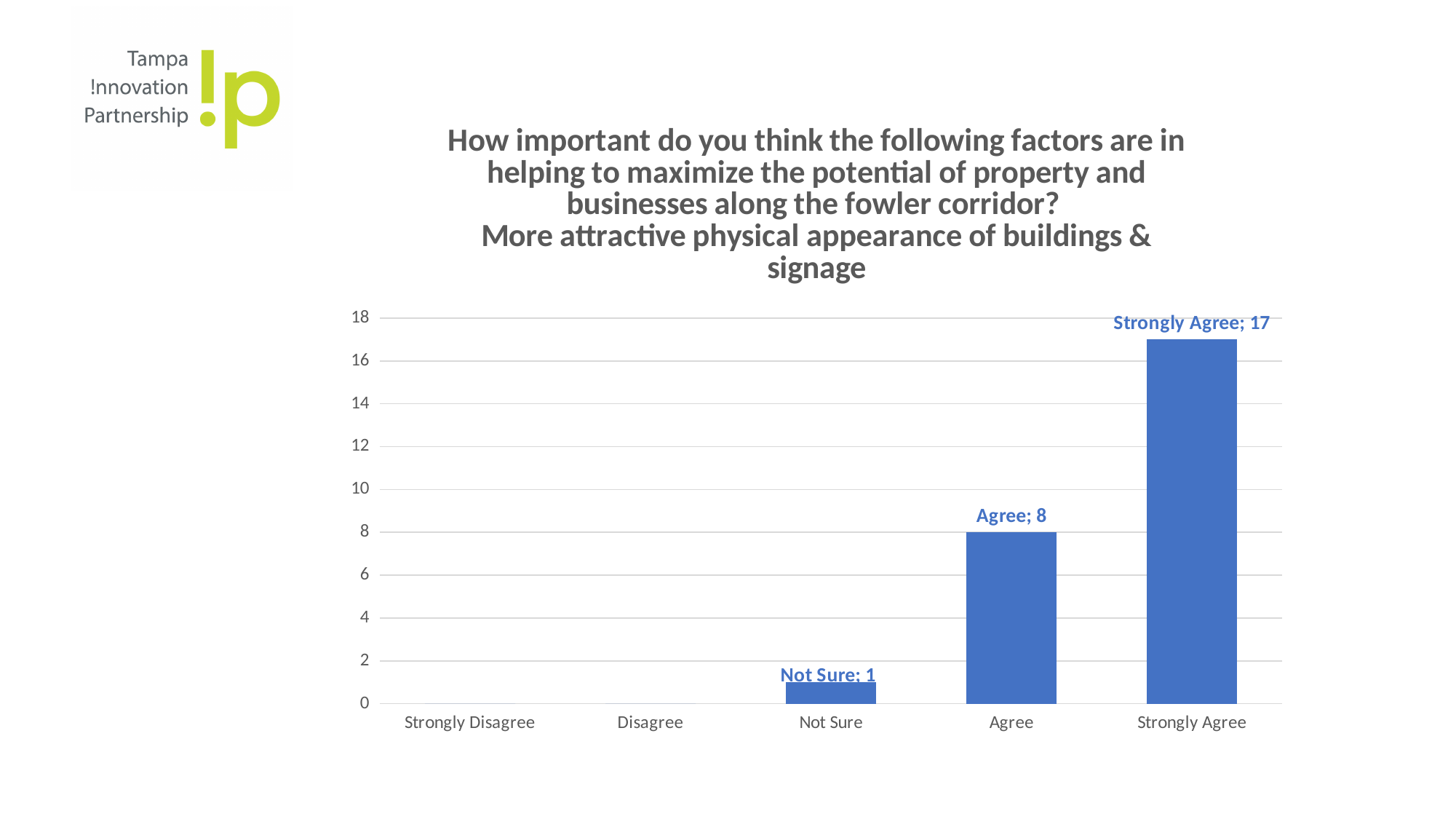
What is the difference between the values for Strongly Agree and Agree? 9 Which is larger, the value for Agree or the value for Not Sure? Agree Which category has the highest value? Strongly Agree What is the highest value shown on the vertical axis? 18 What is the value for Strongly Agree? 17 Do the values rise or fall from Not Sure to Strongly Agree along the x axis? rise What is the value for Agree? 8 What is the difference between the values for Agree and Not Sure? 7 What is the value for Not Sure? 1 Is the value for Strongly Agree greater or less than 10? greater How many categories are shown on the x axis? 5 What kind of chart is shown on the slide? bar chart